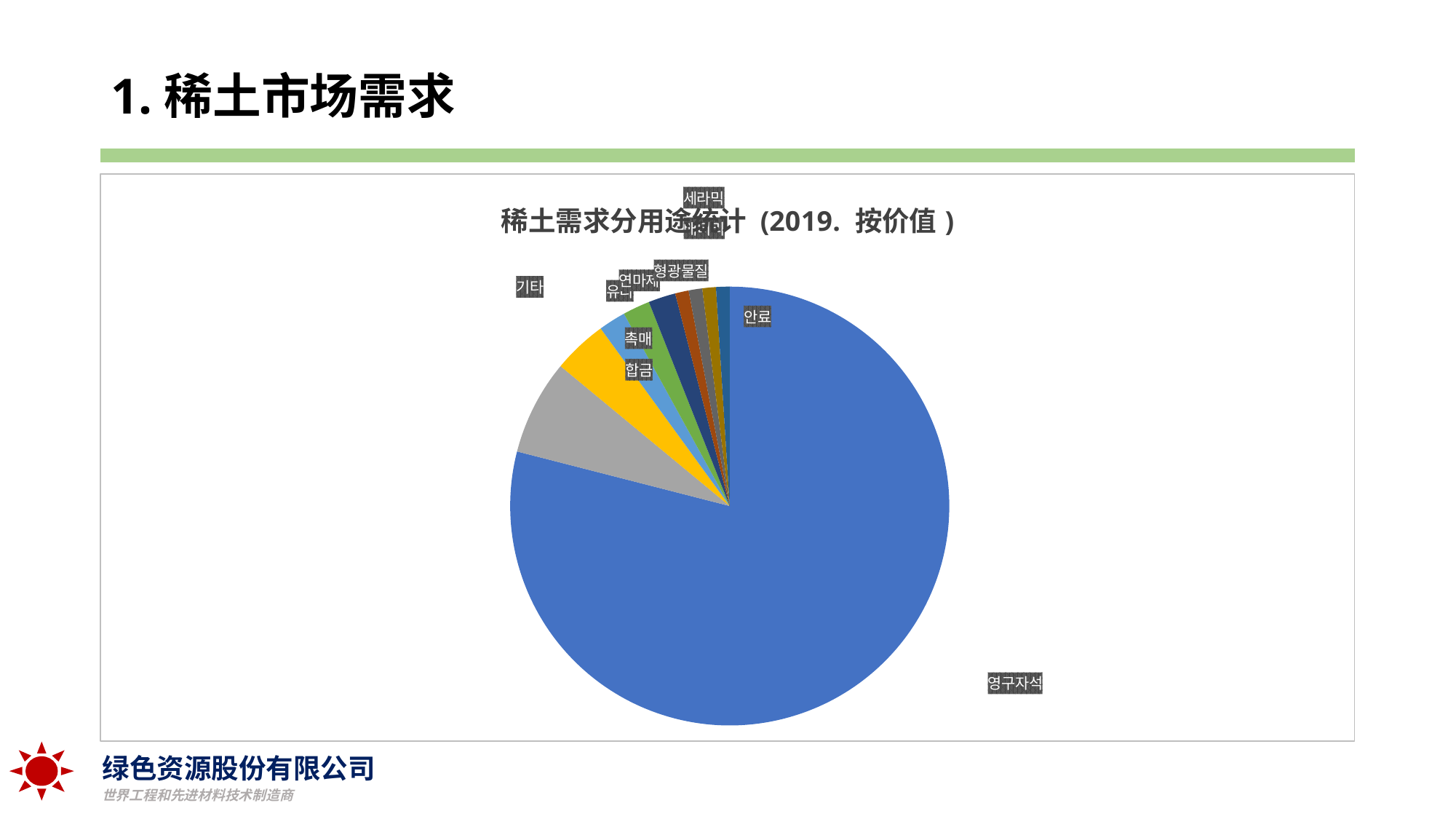
What kind of chart is shown on the slide? pie chart Which slice is larger, 영구자석 or 기타? 영구자석 Which slice is larger, 기타 or 촉매? 기타 Which slice is larger, 기타 or 합금? 기타 What colour is the 영구자석 slice? blue Which category is the second-largest slice of the pie? 기타 What is the title of the chart? 稀土需求分用途统计（2019. 按价值） Which category has the largest slice of the pie? 영구자석